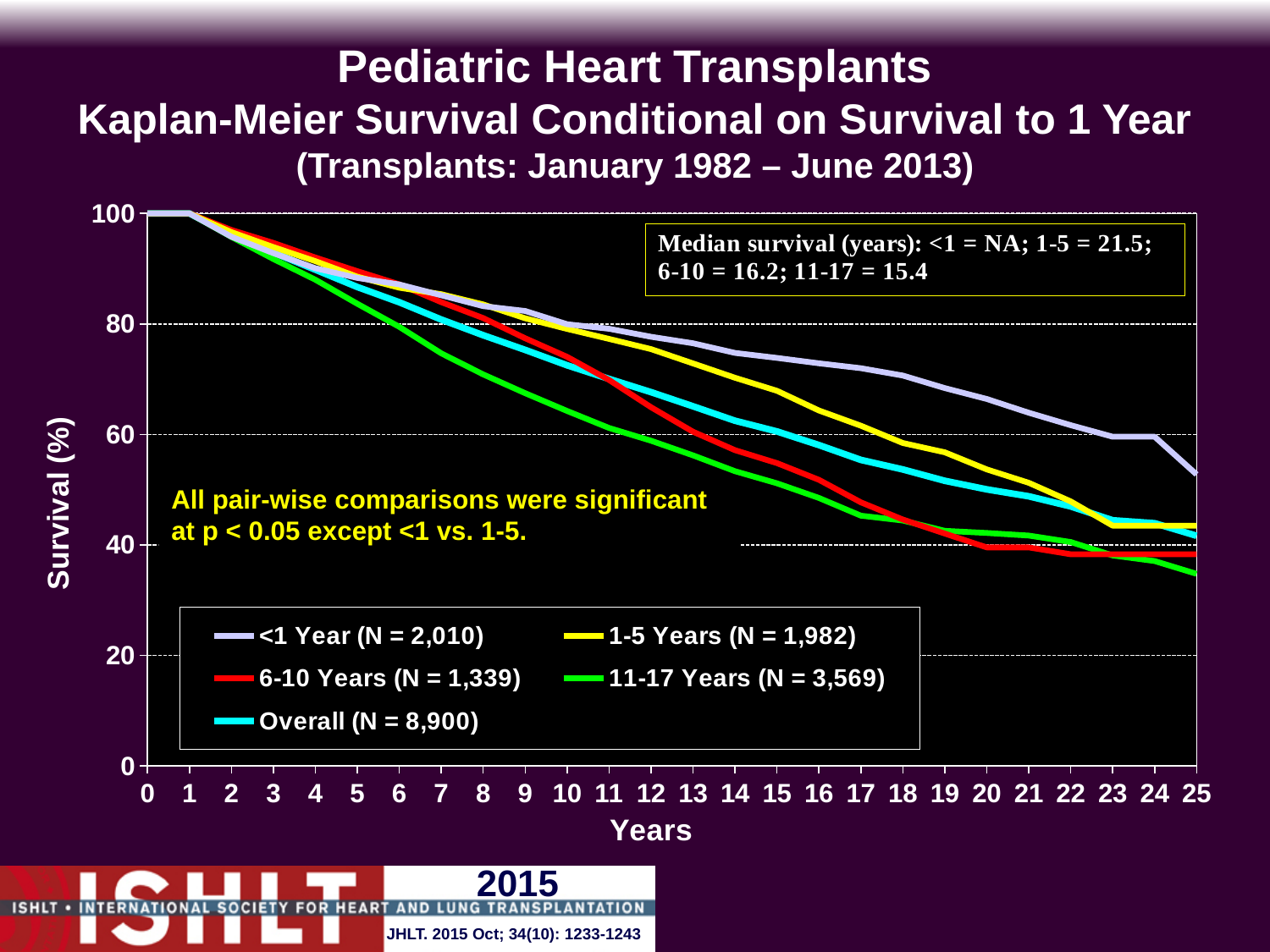
How many series does the legend list? 5 What kind of chart is shown on the slide? line chart What is the N for the Overall group shown in the legend? 8,900 What is the median survival in years for the 6-10 Years group? 16.2 What is the difference in median survival (years) between the 1-5 Years group and the 6-10 Years group? 5.3 Which group has the lowest survival at 25 years? 11-17 Years Is the survival for the 11-17 Years group at 25 years greater or less than 40? less Which group has the highest survival at 25 years? <1 Year What is the median survival given for the <1 Year group? NA What is the median survival in years for the 1-5 Years group? 21.5 What is the median survival in years for the 11-17 Years group? 15.4 Is the survival for the <1 Year group at 20 years greater or less than 60? greater